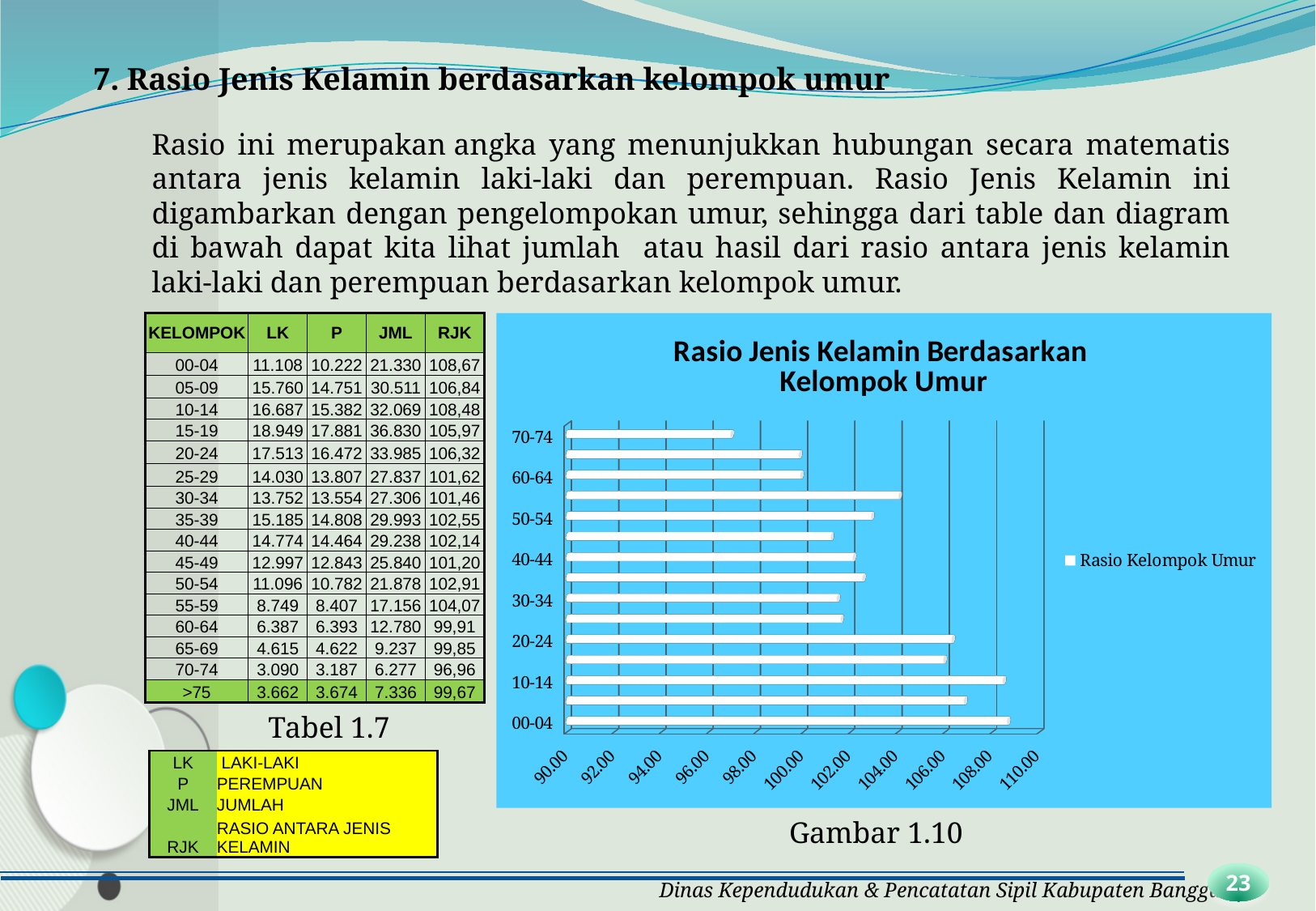
What is the title of the chart? Rasio Jenis Kelamin Berdasarkan Kelompok Umur What kind of chart is shown on the slide? bar chart How many series does the chart legend list? 1 Which is larger in the chart, the value for 20-24 or the value for 30-34? 20-24 Is the value for 00-04 greater or less than 108.00? greater Which is larger in the chart, the value for 10-14 or the value for 40-44? 10-14 What is the legend entry of the chart? Rasio Kelompok Umur According to the table on the slide, what is the RJK value for the 70-74 age group? 96,96 Is the value for 70-74 greater or less than 98.00? less Which age group has the lowest value in the chart? 70-74